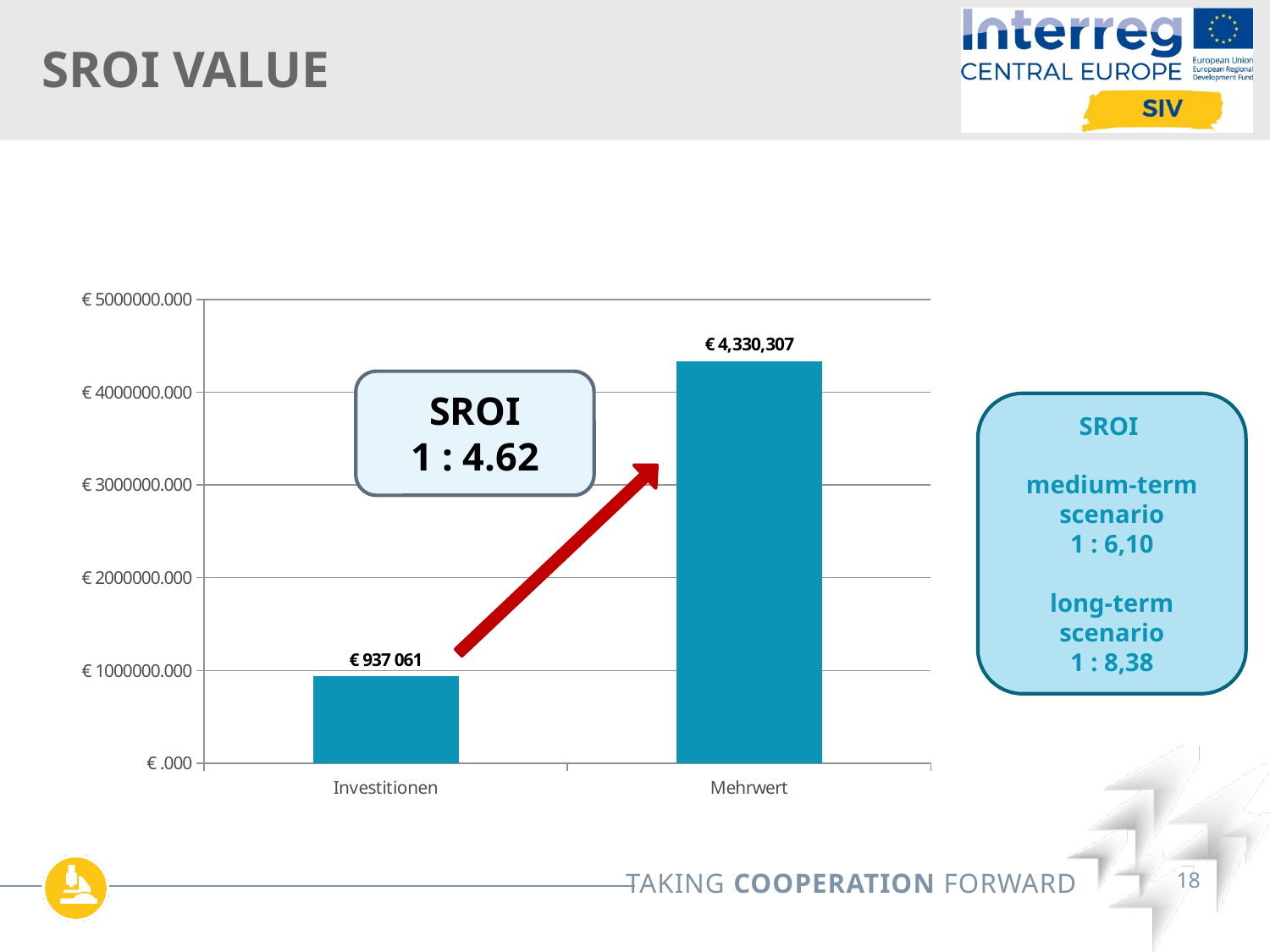
How many categories are shown on the x axis of the chart? 2 Is the value for Investitionen greater or less than € 1000000.000? less Which category has the highest value? Mehrwert What SROI ratio is shown in the callout box on the chart? 1 : 4.62 What is the difference between the value for Mehrwert and the value for Investitionen? € 3,393,246 What is the highest value shown on the y axis of the chart? € 5000000.000 What is the value for Mehrwert? € 4,330,307 Which is larger, the value for Investitionen or the value for Mehrwert? Mehrwert What kind of chart is shown on the slide? bar chart What is the value for Investitionen? € 937 061 Is the value for Mehrwert greater or less than € 4000000.000? greater Which category has the lowest value? Investitionen